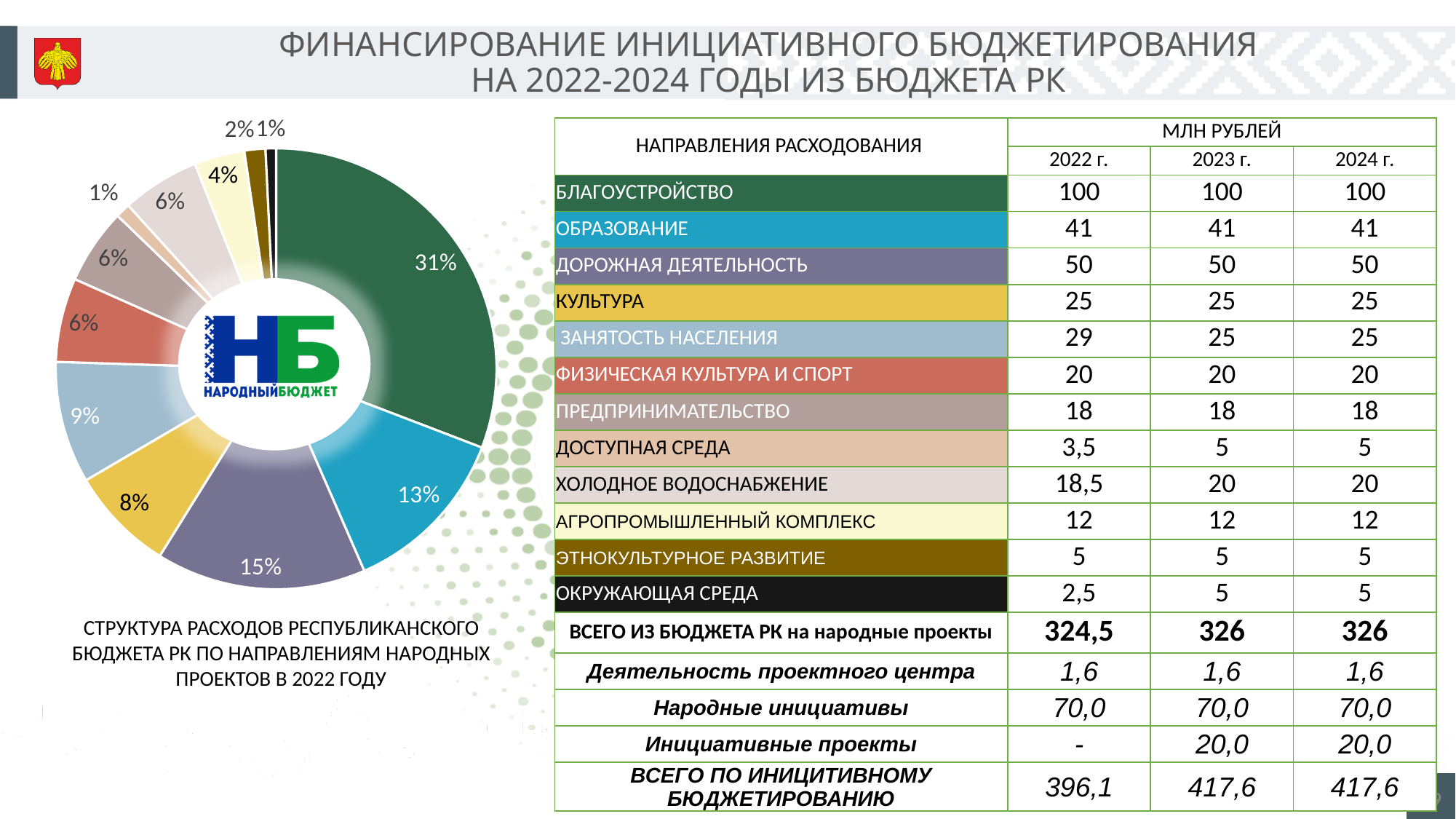
What share of the pie chart does the blue slice (Образование) have? 13% How many slices does the pie chart have? 12 What share of the pie chart does the yellow slice (Культура) have? 8% Which year does the pie chart's caption say the expense structure refers to? 2022 What share of the pie chart does the light blue slice (Занятость населения) have? 9% What is the difference in percentage points between the largest slice (31%) and the second largest slice (15%) of the pie chart? 16 What is the smallest percentage shown on the pie chart? 1% What is the largest percentage shown on the pie chart? 31% Which slice of the pie chart is larger: the purple slice (15%) or the blue slice (13%)? the purple slice (15%) What kind of chart is shown on the left of the slide? pie chart